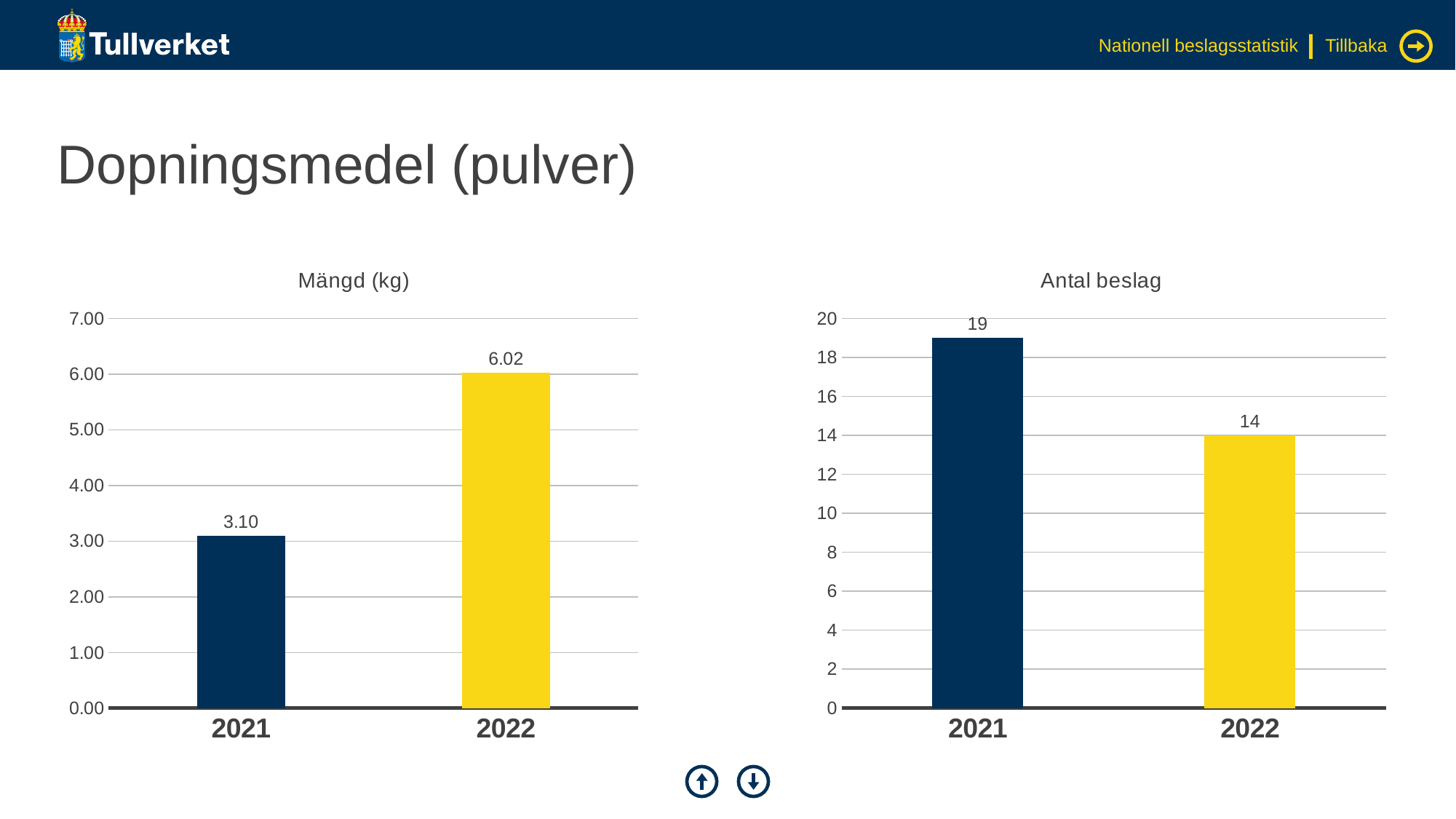
In the 'Antal beslag' chart, which year has the lowest value? 2022 In the 'Mängd (kg)' chart, what is the difference between the 2022 and 2021 values? 2.92 In the 'Mängd (kg)' chart, which year has the highest value? 2022 In the 'Mängd (kg)' chart, what is the value for 2022? 6.02 How many categories are shown on the x axis of the 'Antal beslag' chart? 2 In the 'Antal beslag' chart, what is the difference between the 2021 and 2022 values? 5 In the 'Antal beslag' chart, what is the value for 2022? 14 In the 'Antal beslag' chart, is the value for 2021 larger or smaller than the value for 2022? larger In the 'Antal beslag' chart, what is the value for 2021? 19 In the 'Mängd (kg)' chart, what is the value for 2021? 3.10 What kind of chart is the 'Mängd (kg)' chart? bar chart In the 'Mängd (kg)' chart, does the value rise or fall from 2021 to 2022? rise